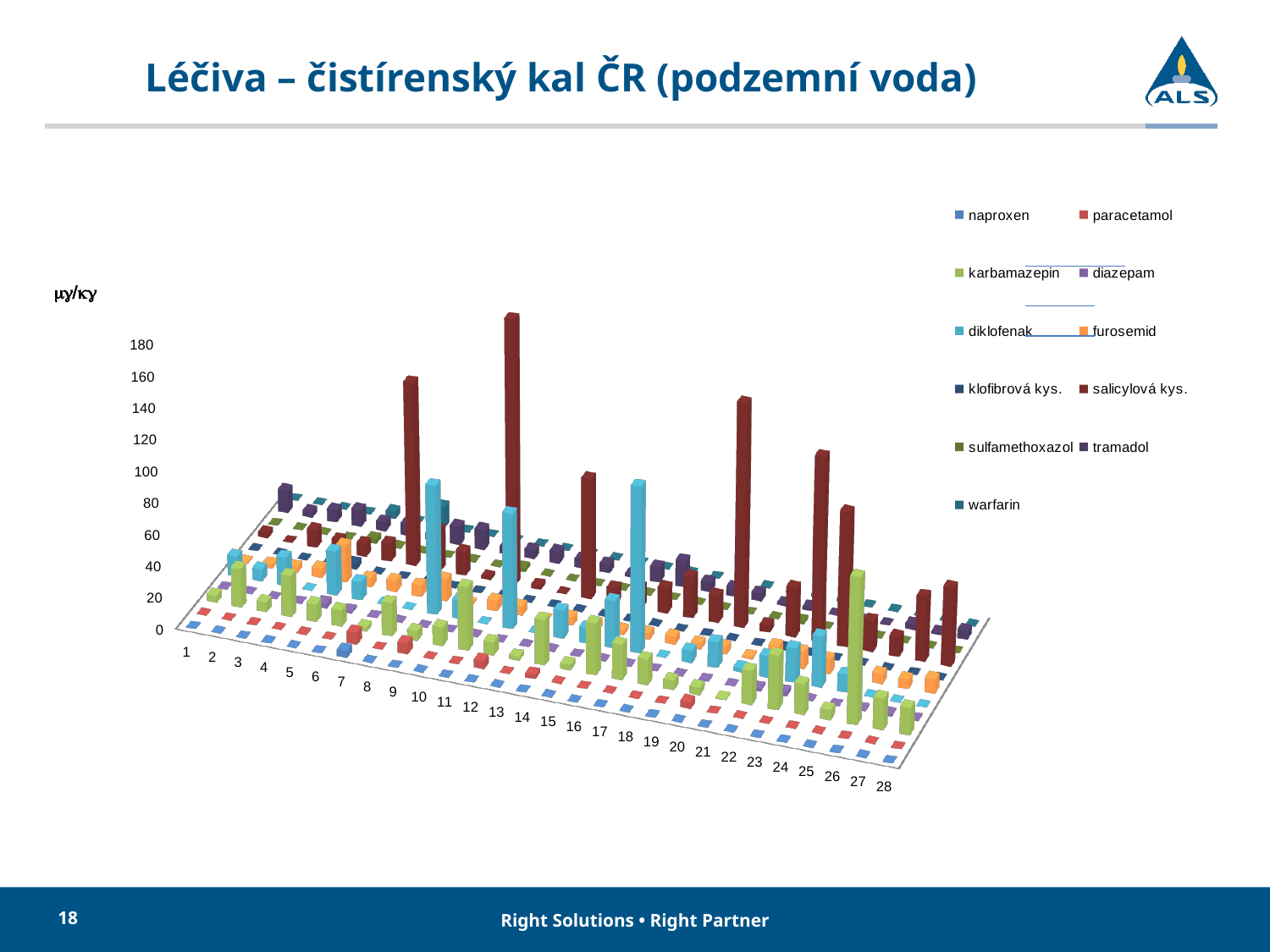
Which series is listed first in the legend? naproxen How many categories are shown along the x axis? 28 What unit is shown on the value axis of the chart? µg/kg How many series does the legend list? 11 What is the title of the slide's chart? Léčiva – čistírenský kal ČR (podzemní voda) What is the interval between consecutive ticks on the value axis? 20 Which series has the tallest bar on the chart? salicylová kys. Is the tallest salicylová kys. bar greater or less than 100? greater What kind of chart is shown on the slide? bar chart What is the lowest tick value shown on the value axis? 0 What is the highest tick value shown on the value axis? 180